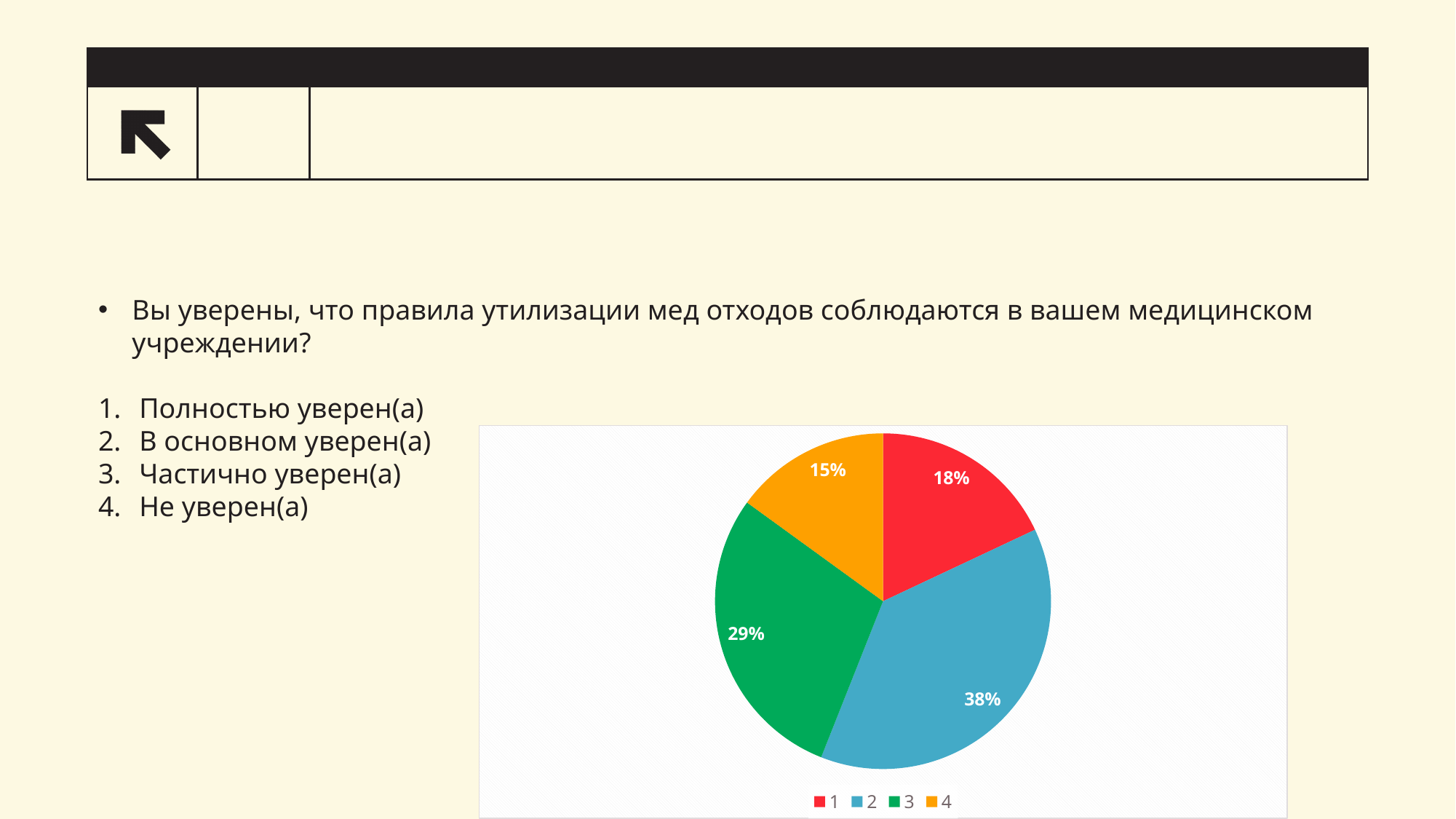
What share of the pie does category 3 have? 29% What share of the pie does category 1 have? 18% What kind of chart is shown on the slide? pie chart Which category has the largest slice of the pie? 2 Which category has the smallest slice of the pie? 4 Which is larger, the share of category 1 or the share of category 4? 1 What share of the pie does category 2 have? 38% What colour is the slice for category 3? green How many entries does the legend list? 4 What is the difference between the shares of category 2 and category 3? 9% How many slices does the pie chart have? 4